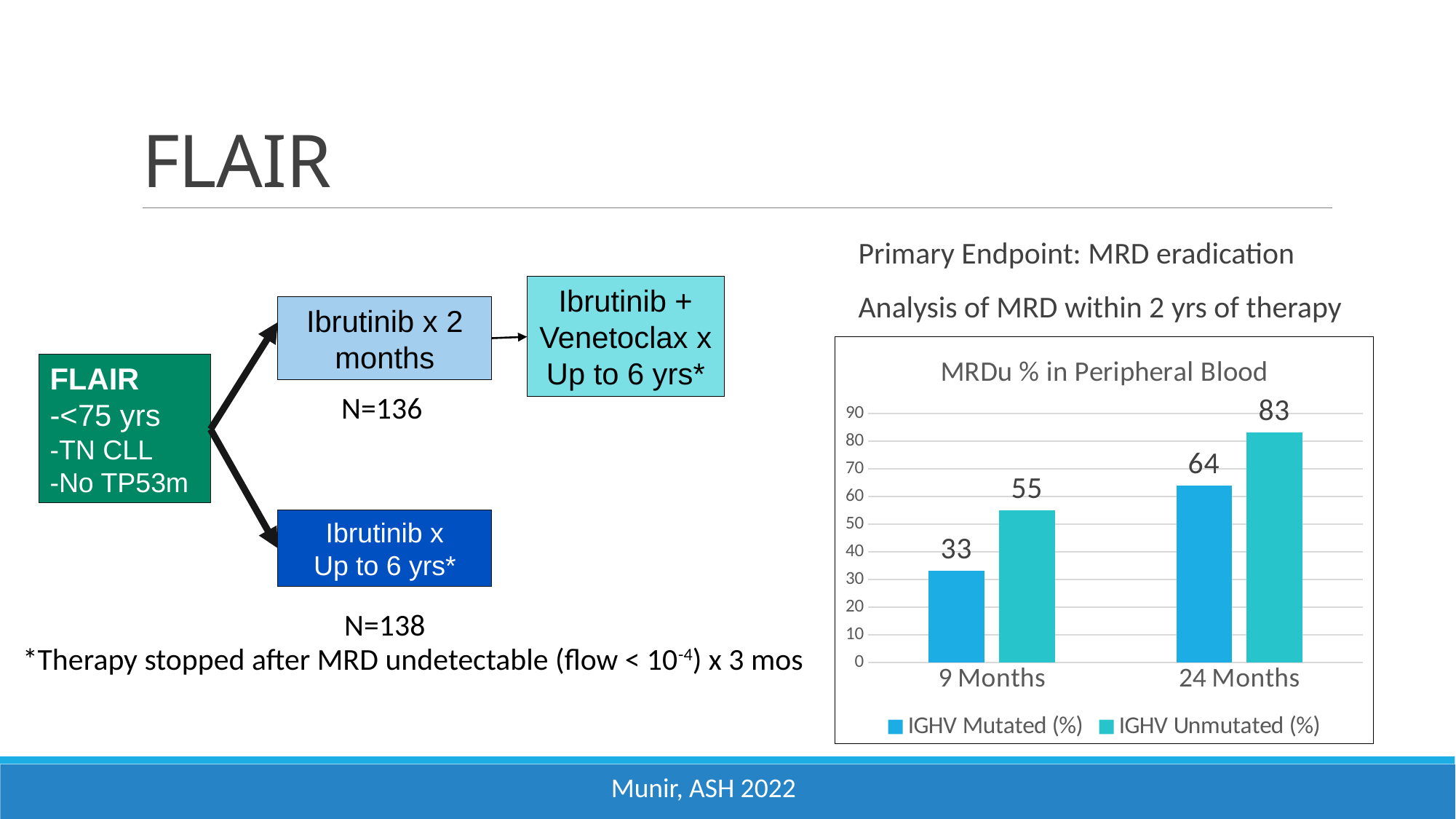
What is the value for IGHV Mutated (%) at 9 Months? 33 Which is larger at 9 Months: IGHV Mutated (%) or IGHV Unmutated (%)? IGHV Unmutated (%) Which bar has the highest value in the chart? IGHV Unmutated (%) at 24 Months What is the value for IGHV Unmutated (%) at 24 Months? 83 What kind of chart is shown on the slide? Bar chart What is the difference between the IGHV Unmutated (%) and IGHV Mutated (%) values at 24 Months? 19 What is the value for IGHV Unmutated (%) at 9 Months? 55 How many series does the chart legend list? 2 Which bar has the lowest value in the chart? IGHV Mutated (%) at 9 Months What is the value for IGHV Mutated (%) at 24 Months? 64 What is the title of the chart? MRDu % in Peripheral Blood How many categories are shown on the x axis of the chart? 2